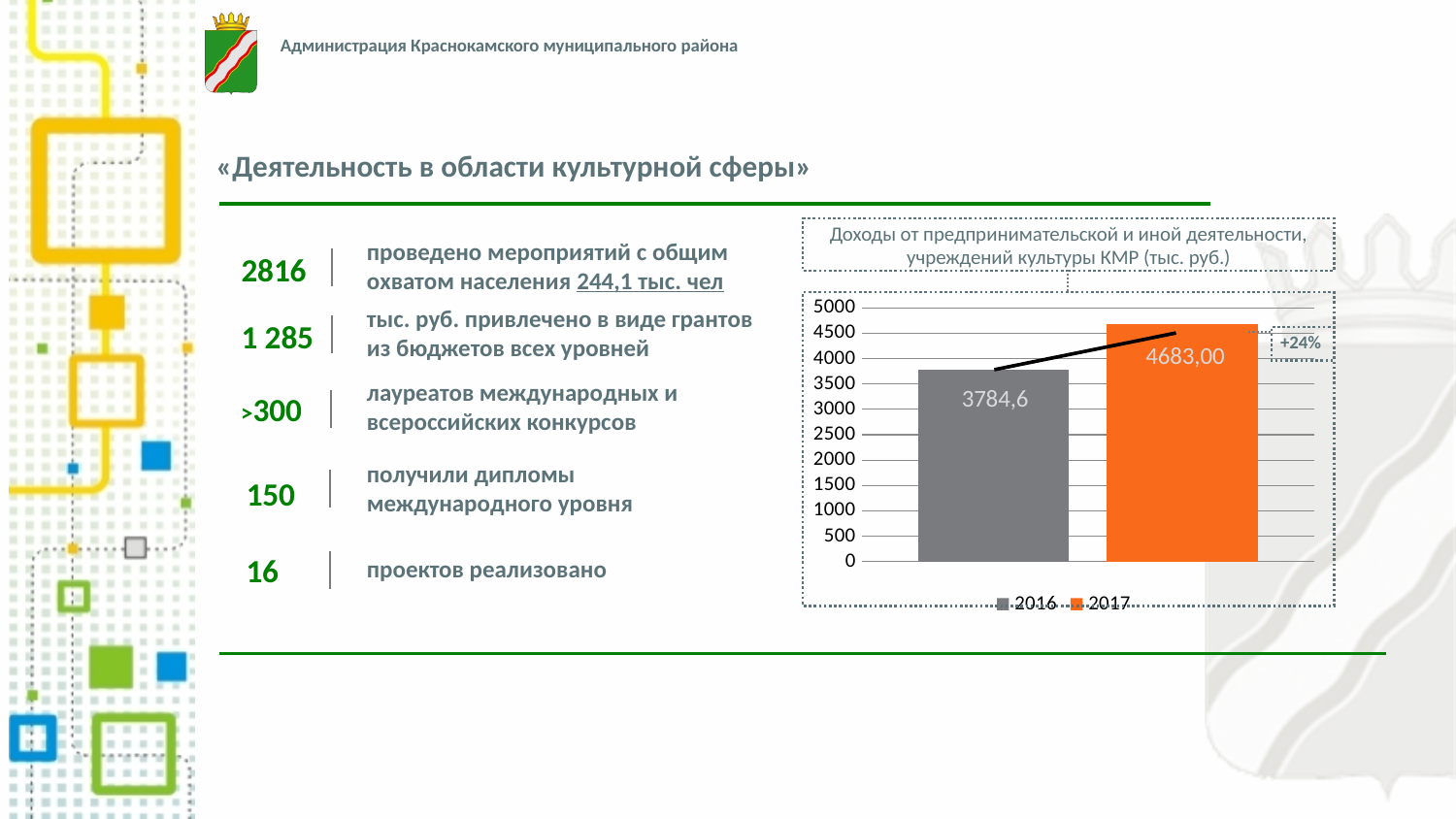
Is the value for 2016 greater or less than 4000? less What percentage change is annotated next to the 2017 bar? +24% How many entries does the chart legend list? 2 Which year has the higher value in the chart? 2017 How many bars are plotted in the chart? 2 What is the difference between the 2017 and 2016 values in the chart? 898,4 Do the values rise or fall from 2016 to 2017? rise What is the value for 2016 in the chart? 3784,6 Which year has the lower value in the chart? 2016 What kind of chart is shown on the slide? bar chart What is the value for 2017 in the chart? 4683,00 Is the value for 2017 greater or less than 4500? greater